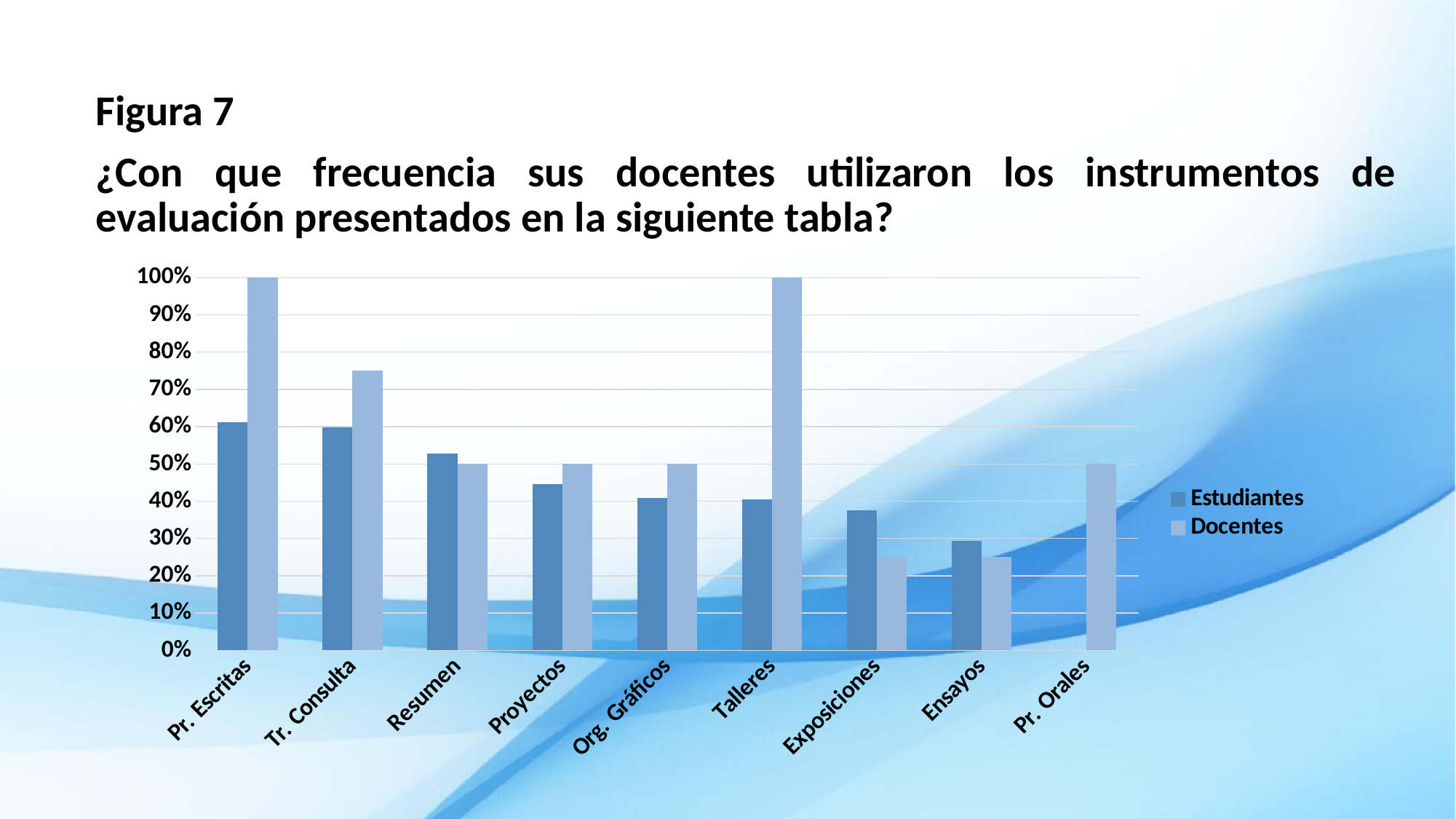
How many series does the legend list? 2 What is the Docentes value for Pr. Orales? 50% What is the Docentes value for Talleres? 100% For Exposiciones, which series has the larger value, Estudiantes or Docentes? Estudiantes What is the difference between the Docentes value for Pr. Escritas and the Docentes value for Proyectos? 50% Is the Estudiantes value for Pr. Escritas greater or less than 50%? greater Is the Estudiantes value for Ensayos greater or less than 40%? less For Talleres, which series has the larger value, Estudiantes or Docentes? Docentes What is the Docentes value for Pr. Escritas? 100% What kind of chart is shown on the slide? bar chart How many categories are shown on the x axis? 9 What is the Docentes value for Resumen? 50%